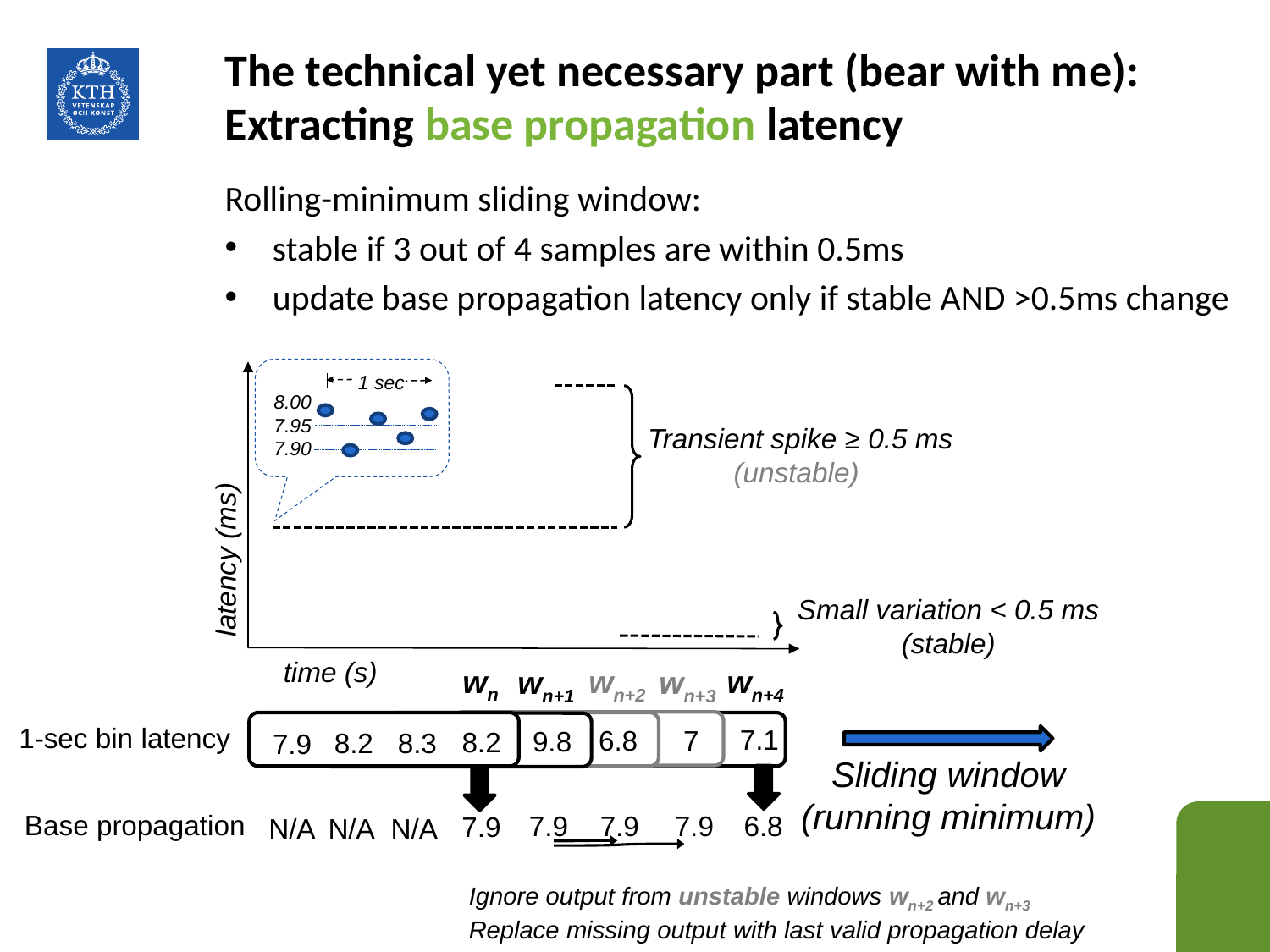
What is the base propagation value shown under window W_n+4? 6.8 What is the label on the vertical axis of the diagram? latency (ms) Which window has the highest 1-sec bin latency value? W_n+1 What is the label on the horizontal axis of the diagram? time (s) What is the 1-sec bin latency value in window W_n? 8.2 What is the 1-sec bin latency value in window W_n+1? 9.8 What is the 1-sec bin latency value in window W_n+3? 7 What is the lowest 1-sec bin latency value shown in the row? 6.8 What is the difference between the 1-sec bin latency values in windows W_n and W_n+1? 1.6 How many base propagation entries are shown as N/A? 3 Which is larger, the 1-sec bin latency in window W_n or in window W_n+4? W_n How many 1-sec bin latency values are shown in the row? 8